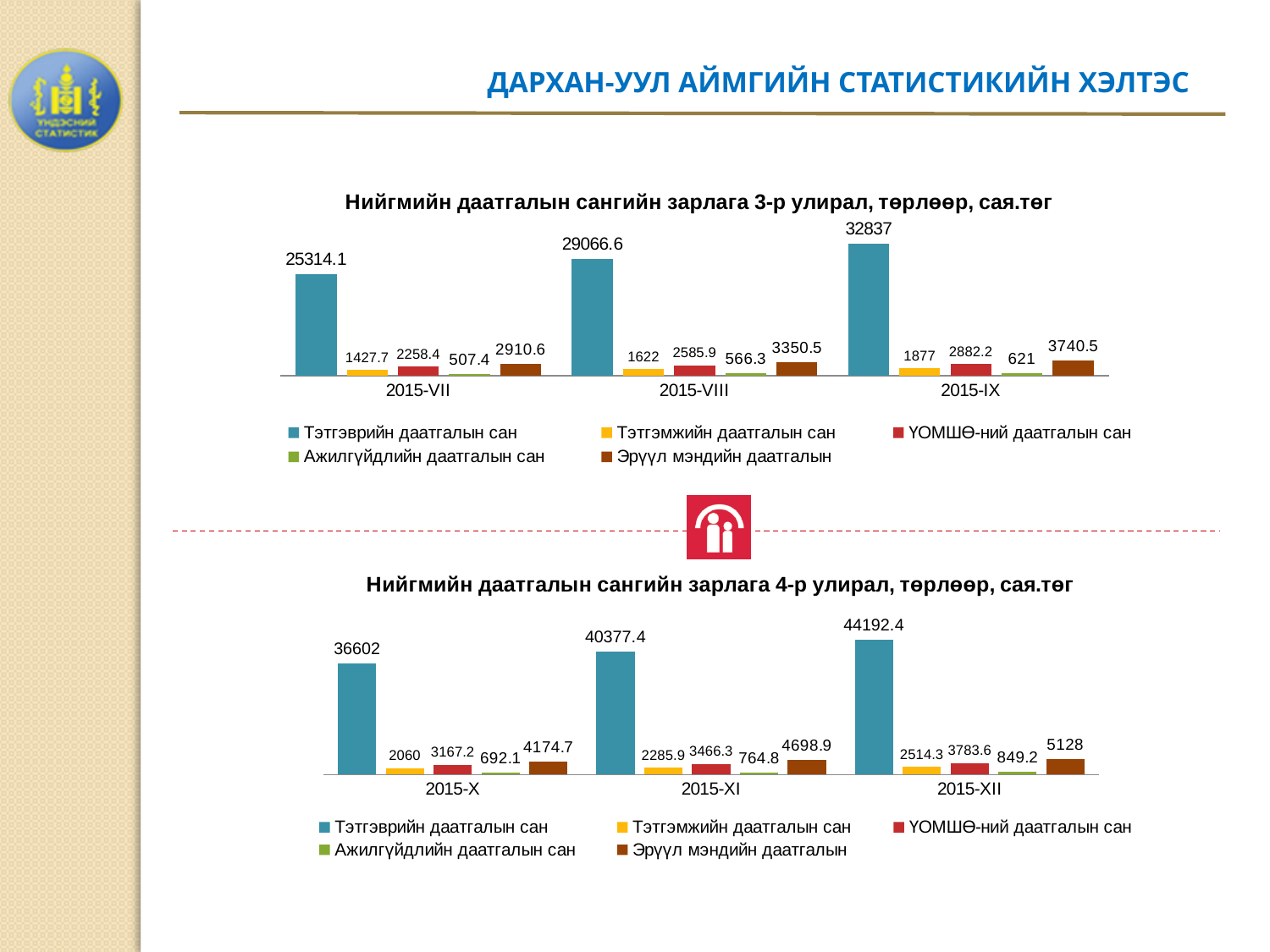
In the bottom chart (4-р улирал), what is the value of Тэтгэмжийн даатгалын сан for 2015-XI? 2285.9 In the top chart (3-р улирал), which month has the highest value for Тэтгэврийн даатгалын сан? 2015-IX In the bottom chart (4-р улирал), which is larger: ҮОМШӨ-ний даатгалын сан for 2015-X or Тэтгэмжийн даатгалын сан for 2015-XII? ҮОМШӨ-ний даатгалын сан for 2015-X In the bottom chart (4-р улирал), what is the value of Эрүүл мэндийн даатгалын for 2015-XII? 5128 What kind of chart is the bottom chart (4-р улирал)? bar chart In the bottom chart (4-р улирал), does the value of Тэтгэврийн даатгалын сан rise or fall from 2015-X to 2015-XII? rise In the top chart (3-р улирал), what is the value of Эрүүл мэндийн даатгалын for 2015-IX? 3740.5 In the top chart (3-р улирал), which series has the lowest value in 2015-VIII? Ажилгүйдлийн даатгалын сан In the top chart (3-р улирал), how many series does the legend list? 5 In the top chart (3-р улирал), what is the difference between the Тэтгэврийн даатгалын сан values for 2015-IX and 2015-VII? 7522.9 In the top chart (3-р улирал), what is the value of Тэтгэврийн даатгалын сан for 2015-VII? 25314.1 In the bottom chart (4-р улирал), how many months are shown on the x axis? 3